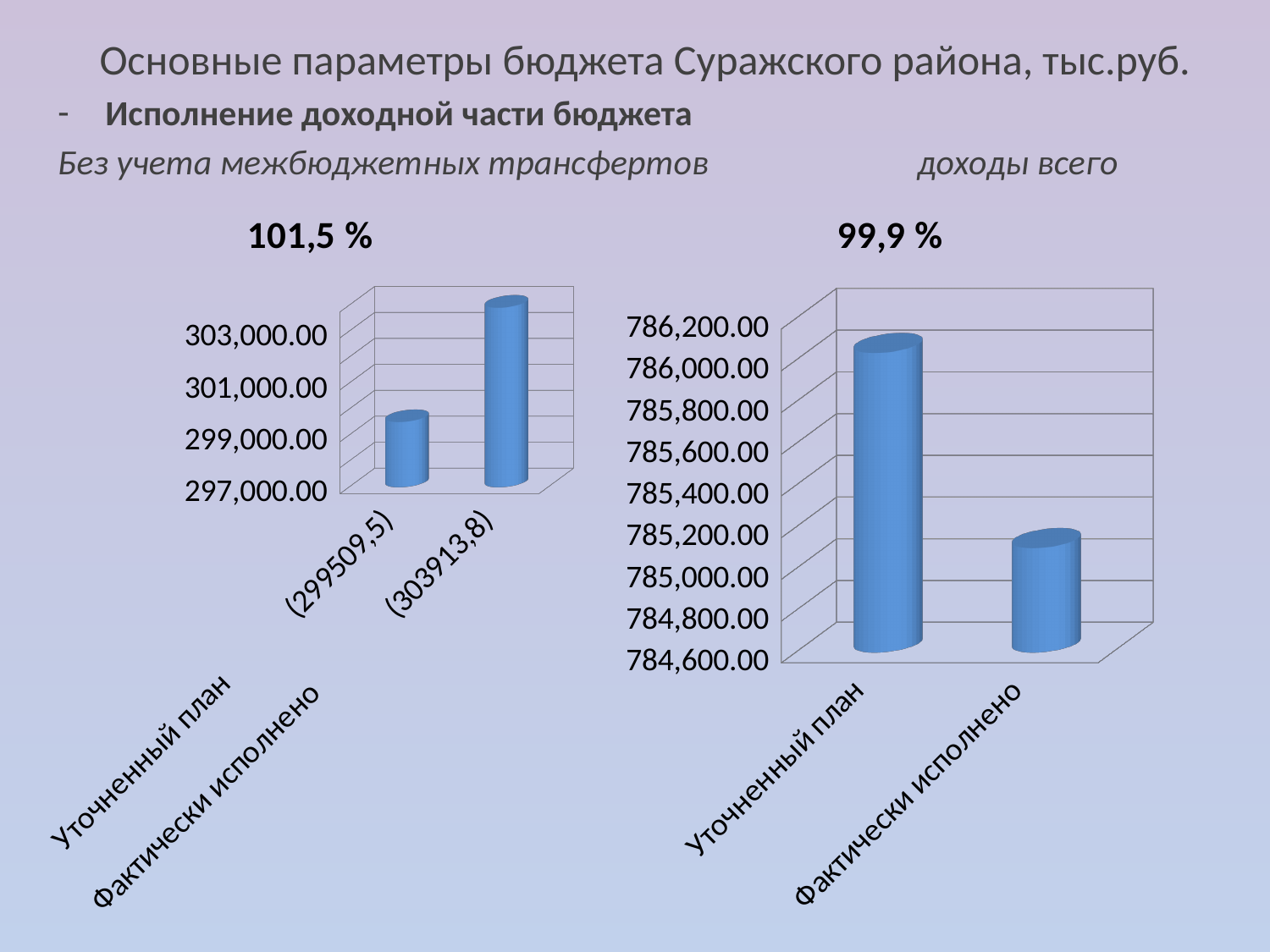
How many categories does the right chart (доходы всего) show? 2 On the left chart (Без учета межбюджетных трансфертов), what value is shown for Уточненный план? 299509,5 On the right chart (доходы всего), is the value for Уточненный план greater or less than 785,800.00? greater On the left chart (Без учета межбюджетных трансфертов), what value is shown for Фактически исполнено? 303913,8 On the left chart (Без учета межбюджетных трансфертов), what is the difference between Фактически исполнено and Уточненный план? 4404,3 On the left chart (Без учета межбюджетных трансфертов), which category has the higher value? Фактически исполнено What kind of chart is the left chart (Без учета межбюджетных трансфертов)? bar chart On the right chart (доходы всего), is the value for Фактически исполнено greater or less than 785,400.00? less What execution percentage is shown above the left chart (Без учета межбюджетных трансфертов)? 101,5 % On the right chart (доходы всего), is Уточненный план or Фактически исполнено larger? Уточненный план What execution percentage is shown above the right chart (доходы всего)? 99,9 % On the right chart (доходы всего), which category has the lower value? Фактически исполнено